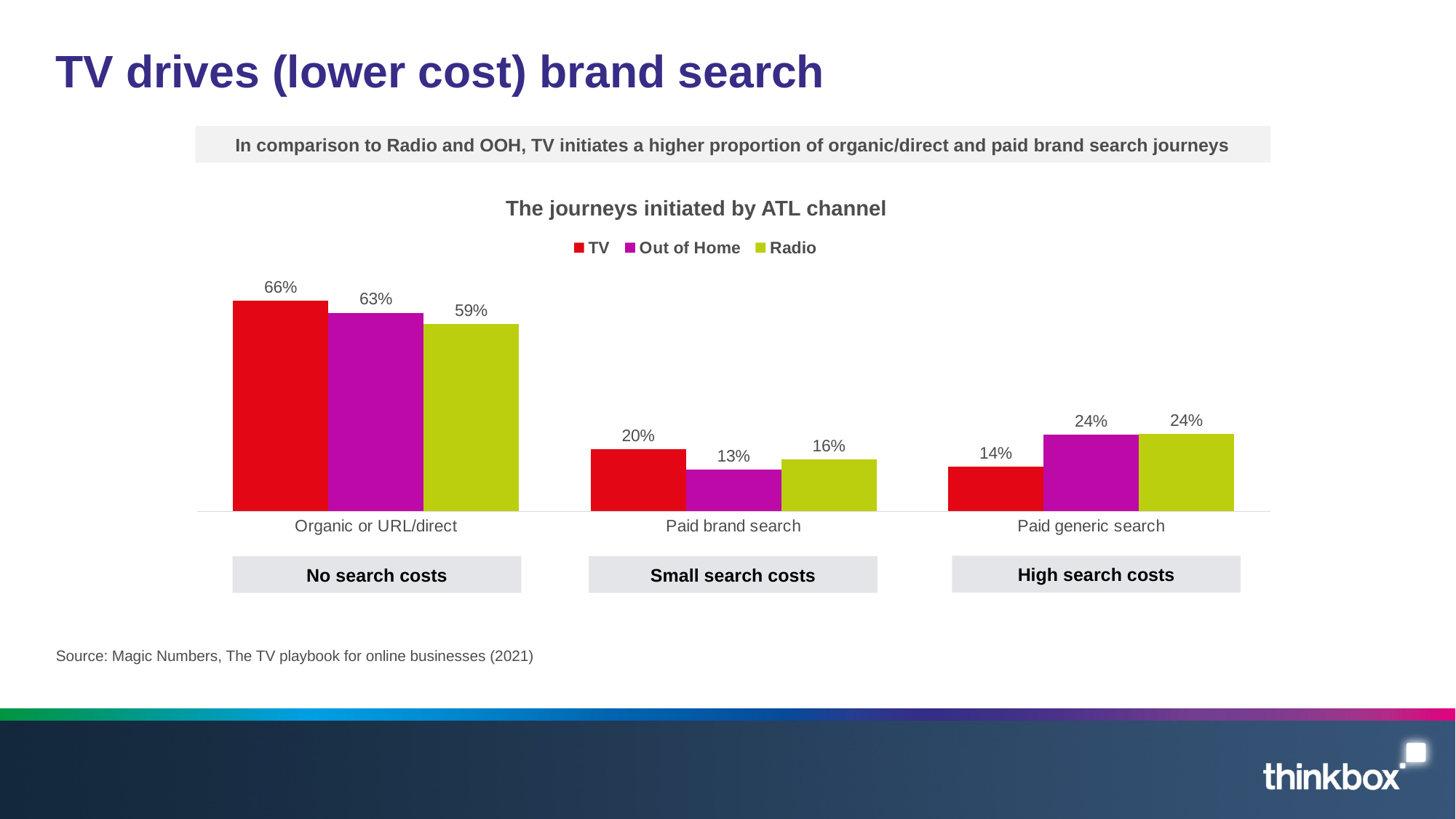
What kind of chart is shown on the slide? Bar chart What is the value for Radio in the Paid generic search category? 24% What is the difference between the TV and Radio values in the Organic or URL/direct category? 7% What is the difference between the TV and Out of Home values in the Paid brand search category? 7% Which channel has the highest value in the Organic or URL/direct category? TV What is the value for TV in the Organic or URL/direct category? 66% What is the title of the chart? The journeys initiated by ATL channel How many categories are shown on the x axis? 3 Which is larger in the Paid brand search category: Radio or Out of Home? Radio How many series does the legend list? 3 What is the value for Out of Home in the Paid brand search category? 13% Which channel has the lowest value in the Paid generic search category? TV